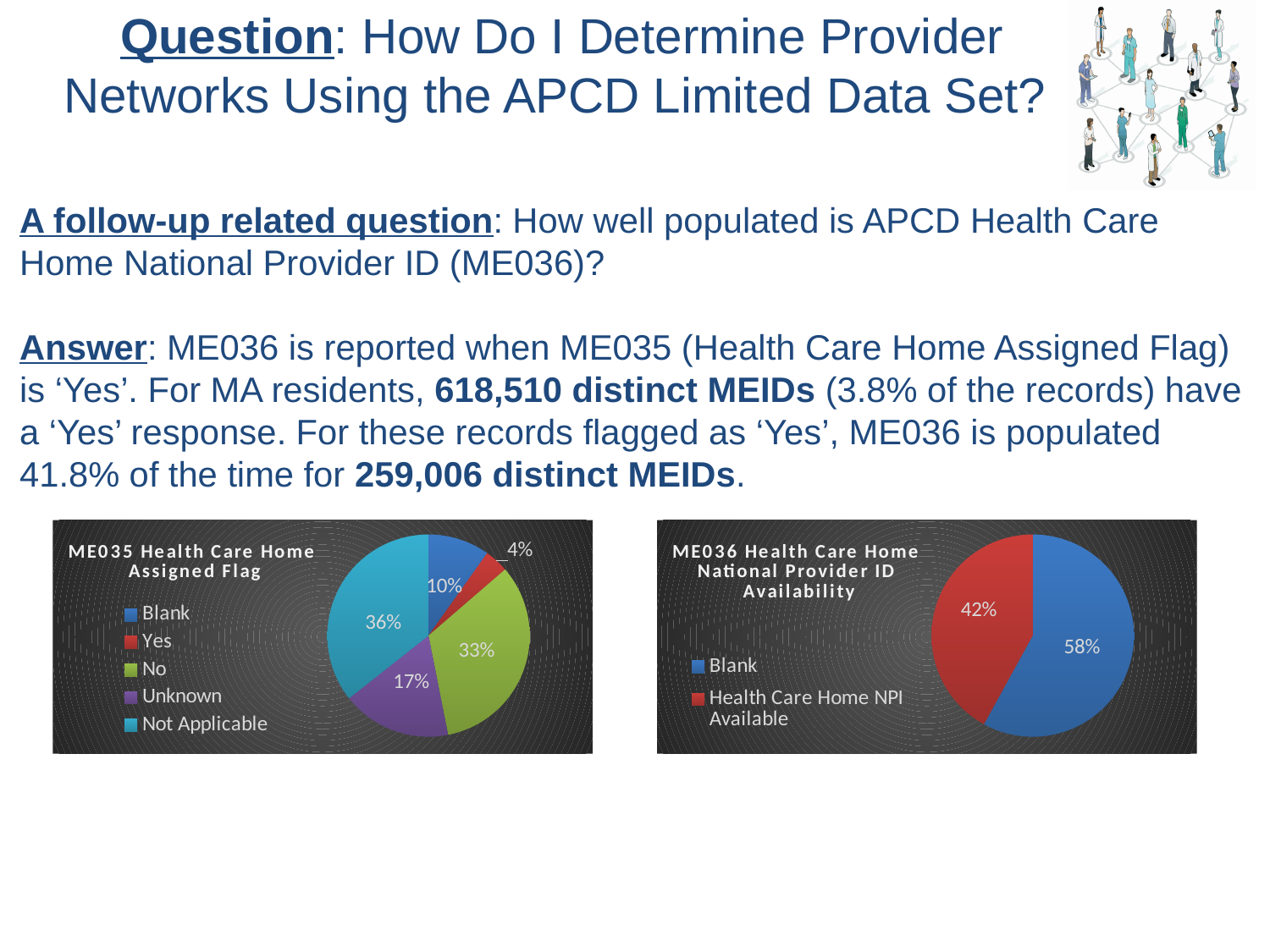
In the ME036 Health Care Home National Provider ID Availability chart, what percentage is 'Blank'? 58% What type of chart is the ME036 Health Care Home National Provider ID Availability chart? Pie chart In the ME035 Health Care Home Assigned Flag chart, what percentage is labelled for 'Yes'? 4% In the ME035 Health Care Home Assigned Flag chart, what percentage is shown for 'No'? 33% In the ME035 Health Care Home Assigned Flag chart, which is larger, 'Blank' or 'Unknown'? Unknown In the ME035 Health Care Home Assigned Flag chart, which category has the largest slice? Not Applicable In the ME036 Health Care Home National Provider ID Availability chart, what share is 'Health Care Home NPI Available'? 42% How many categories does the legend of the ME035 Health Care Home Assigned Flag chart list? 5 In the ME035 Health Care Home Assigned Flag chart, what is the difference between the 'No' and 'Unknown' percentages? 16% In the ME036 Health Care Home National Provider ID Availability chart, what colour is the 'Blank' slice? Blue In the ME035 Health Care Home Assigned Flag chart, what share of the pie is 'Not Applicable'? 36% In the ME035 Health Care Home Assigned Flag chart, which category has the smallest slice? Yes